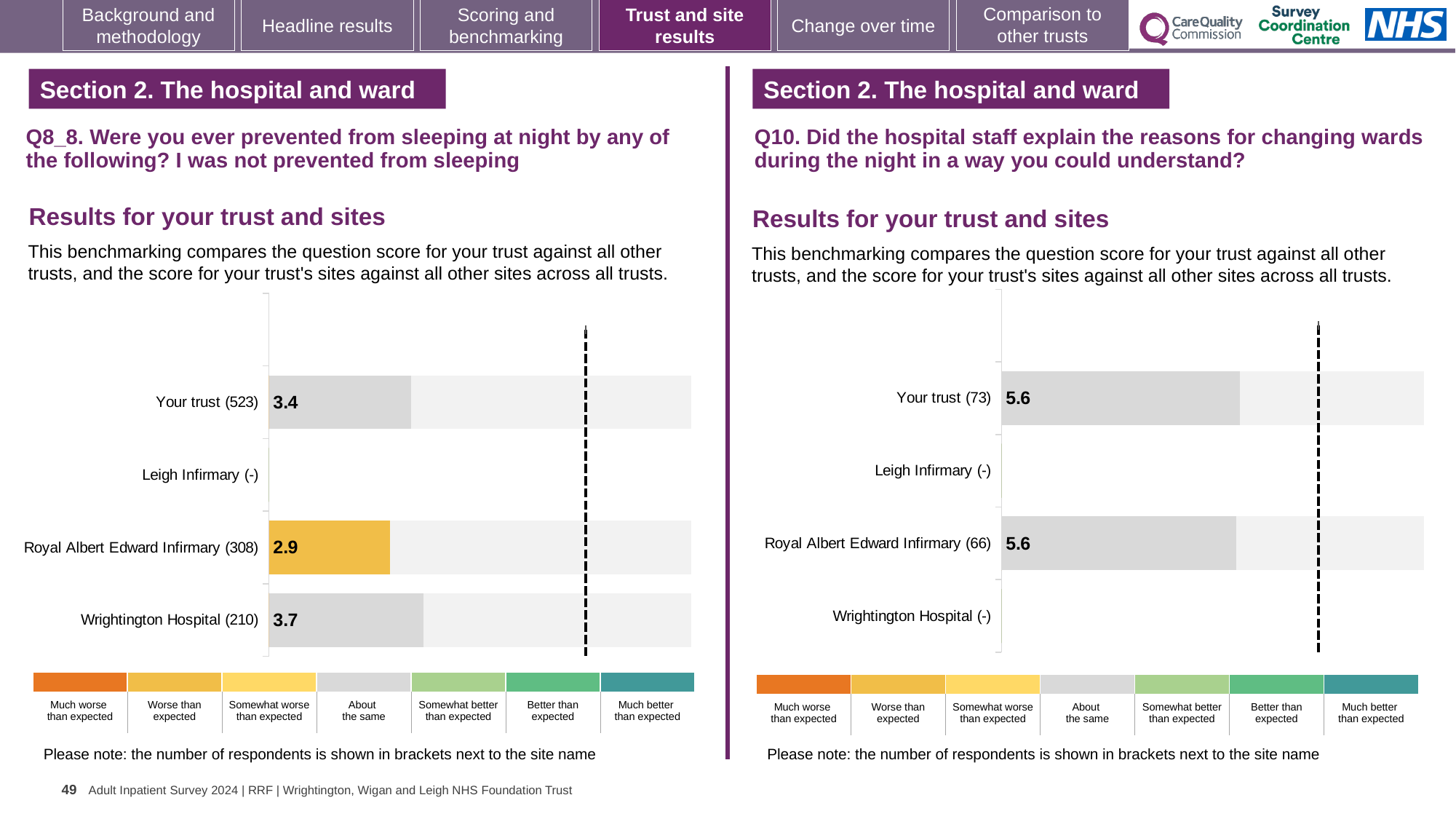
In the right chart (Q10), what is the score for Your trust? 5.6 In the right chart (Q10), how many respondents are shown for Royal Albert Edward Infirmary? 66 In the left chart (Q8_8), what is the score for Royal Albert Edward Infirmary? 2.9 In the left chart (Q8_8), how many respondents are shown for Your trust? 523 What kind of chart is used on the left side of the slide (Q8_8)? Bar chart In the left chart (Q8_8), what is the difference between the scores for Wrightington Hospital and Royal Albert Edward Infirmary? 0.8 In the right chart (Q10), what is the score for Royal Albert Edward Infirmary? 5.6 In the left chart (Q8_8), what is the score for Wrightington Hospital? 3.7 In the left chart (Q8_8), which site has the lowest plotted score? Royal Albert Edward Infirmary In the left chart (Q8_8), what is the score for Your trust? 3.4 In the left chart (Q8_8), which site has the highest score? Wrightington Hospital In the left chart (Q8_8), which is larger: the score for Your trust or the score for Royal Albert Edward Infirmary? Your trust